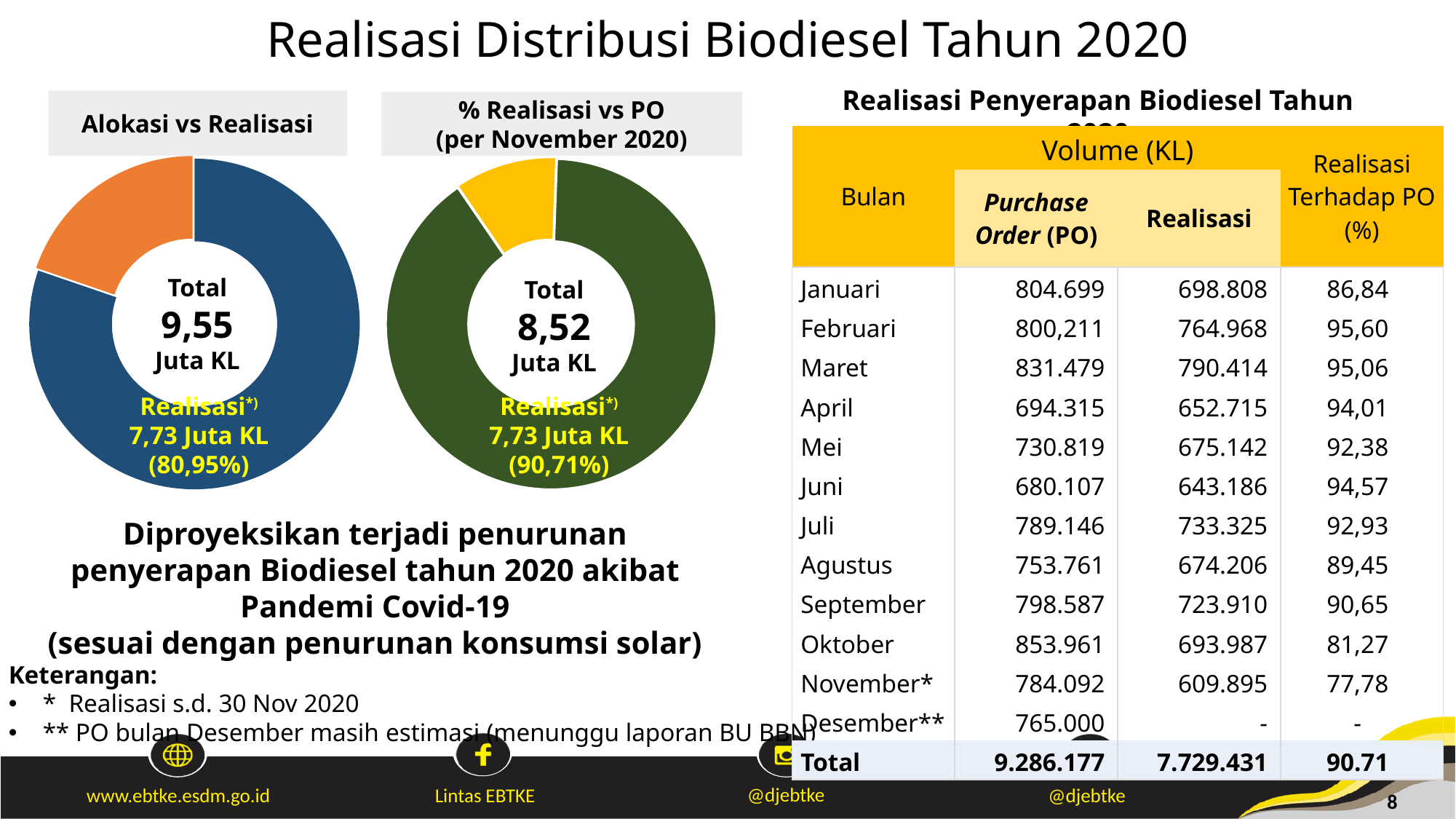
In the '% Realisasi vs PO (per November 2020)' chart, what is the total value shown in the centre? 8,52 Juta KL In the 'Alokasi vs Realisasi' chart, which slice is larger, the blue one or the orange one? Blue Which chart shows the larger total, 'Alokasi vs Realisasi' or '% Realisasi vs PO (per November 2020)'? Alokasi vs Realisasi What is the title of the right-hand donut chart? % Realisasi vs PO (per November 2020) In the '% Realisasi vs PO (per November 2020)' chart, what is the difference between the total and the Realisasi value? 0,79 Juta KL In the 'Alokasi vs Realisasi' chart, what is the total value shown in the centre? 9,55 Juta KL What kind of chart is the 'Alokasi vs Realisasi' chart? Pie (donut) chart In the '% Realisasi vs PO (per November 2020)' chart, what percentage share does Realisasi represent? 90,71% In the 'Alokasi vs Realisasi' chart, what is the Realisasi value? 7,73 Juta KL In the 'Alokasi vs Realisasi' chart, what percentage share does Realisasi represent? 80,95% In the 'Alokasi vs Realisasi' chart, what is the difference between the total and the Realisasi value? 1,82 Juta KL How many slices does the 'Alokasi vs Realisasi' donut chart have? 2